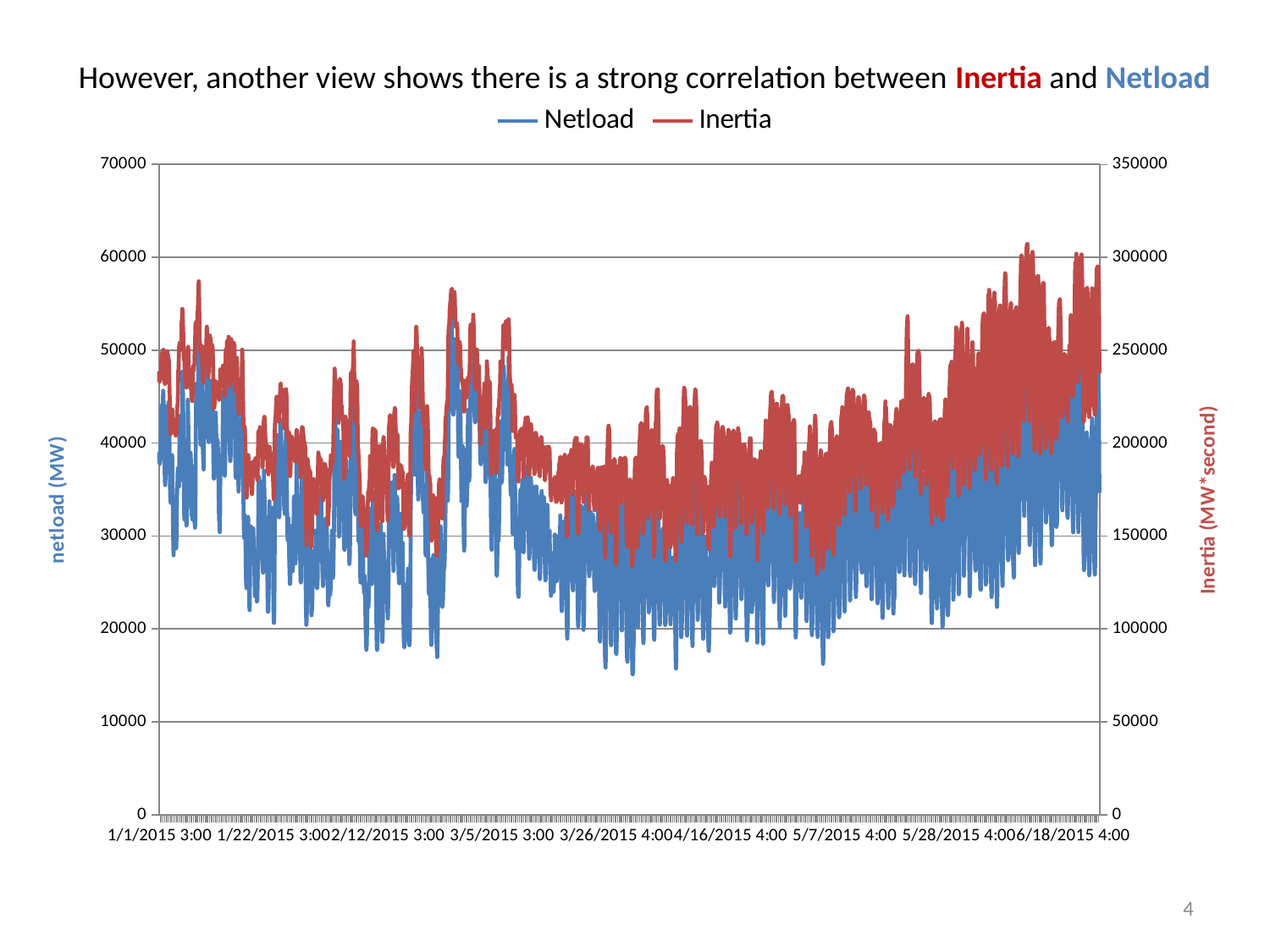
Is the highest Inertia value on the chart greater or less than 250000? greater How many date labels are shown along the x axis? 9 How many series does the legend list? 2 What kind of chart is shown on the slide? line chart What is the first date label on the x axis? 1/1/2015 3:00 Does the Inertia series generally rise or fall between 5/28/2015 and 6/18/2015? rise What is the title of the right-hand vertical axis? Inertia (MW*second) Is the lowest Netload value on the chart greater or less than 10000? greater Which series is plotted in red? Inertia Is the lowest Inertia value on the chart greater or less than 100000? greater Is the Inertia level around 6/18/2015 higher or lower than around 3/26/2015? higher